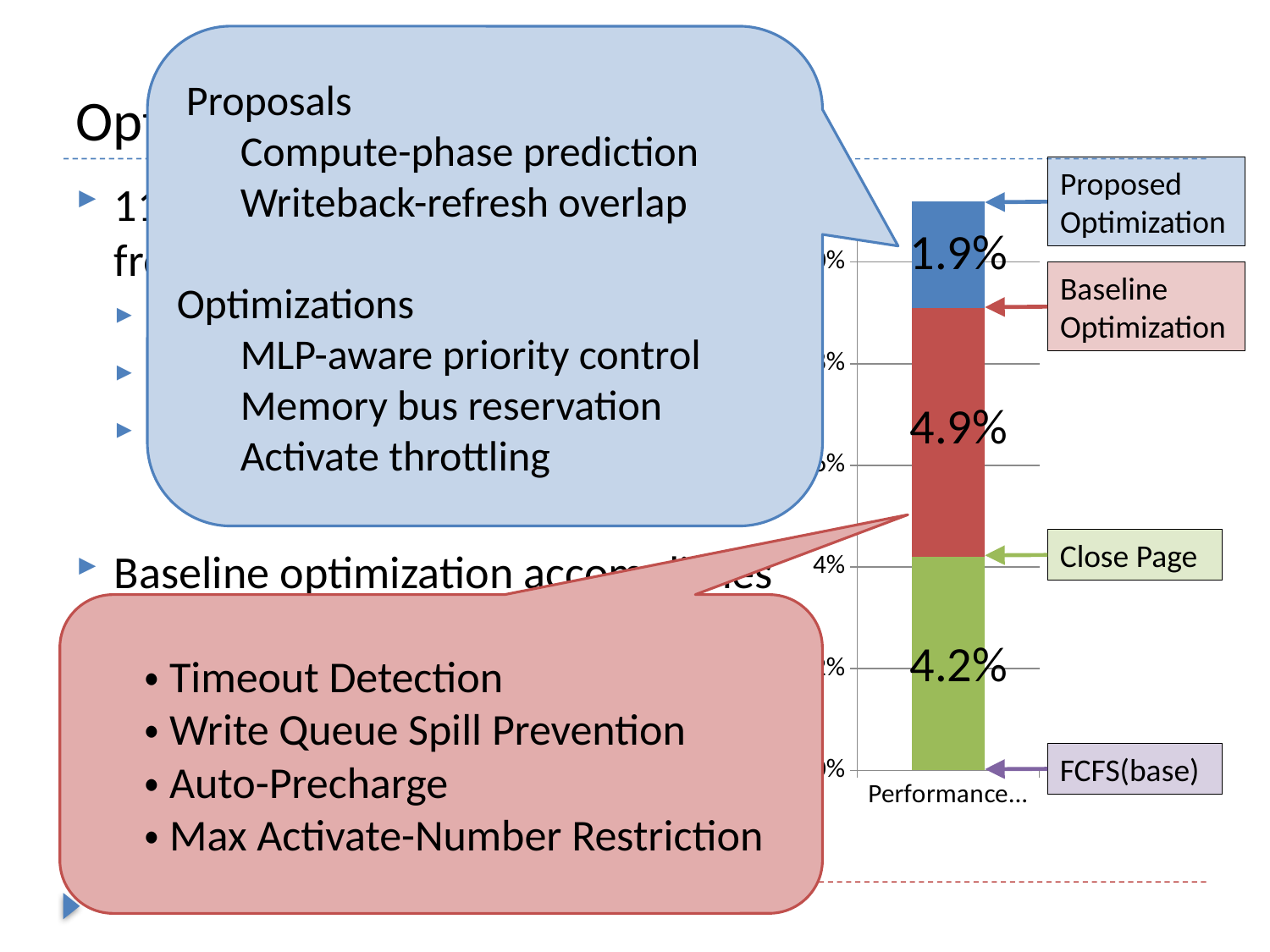
What is the total of the three segments in the stacked bar? 11% Which segment of the stacked bar has the largest value? The red segment (4.9%) What is the difference between the red segment (4.9%) and the blue segment (1.9%)? 3.0% Which annotation label points to the top of the stacked bar? Proposed Optimization Which is larger, the green segment or the blue segment of the stacked bar? The green segment How many bars does the chart contain? 1 What value is printed on the red (middle) segment of the stacked bar? 4.9% What kind of chart is shown on the slide? Stacked bar chart What is the difference between the red segment (4.9%) and the green segment (4.2%)? 0.7% Which segment of the stacked bar has the smallest value? The blue segment (1.9%) What value is printed on the green (bottom) segment of the stacked bar? 4.2% What value is printed on the blue (top) segment of the stacked bar? 1.9%